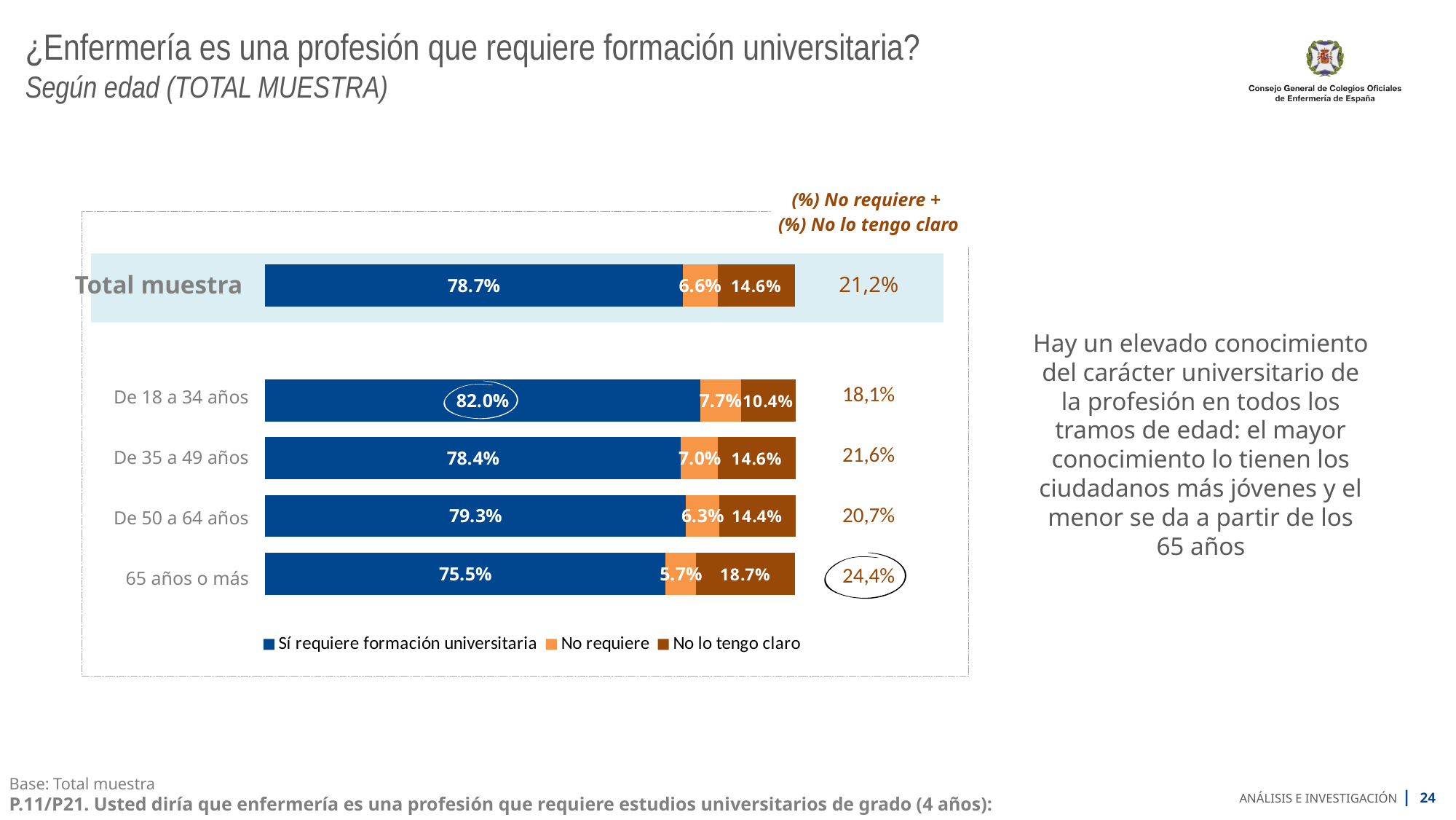
What percentage of the 'Total muestra' answered 'No lo tengo claro'? 14.6% Which age group has the lowest percentage for 'Sí requiere formación universitaria'? 65 años o más Which age group has the highest percentage for 'Sí requiere formación universitaria'? De 18 a 34 años What is the combined '(%) No requiere + (%) No lo tengo claro' value shown for the '65 años o más' group? 24,4% What percentage of the '65 años o más' group answered 'No requiere'? 5.7% Which colour represents 'No requiere' in the chart? Orange How many series does the legend list? 3 Which group has a larger 'No lo tengo claro' percentage, 'De 35 a 49 años' or '65 años o más'? 65 años o más What kind of chart is shown on the slide? Stacked bar chart What is the difference between the 'Sí requiere formación universitaria' percentages for 'De 18 a 34 años' and '65 años o más'? 6.5 percentage points How many categories (bars) are shown in the chart, including 'Total muestra'? 5 What percentage of the 'De 18 a 34 años' group answered 'Sí requiere formación universitaria'? 82.0%